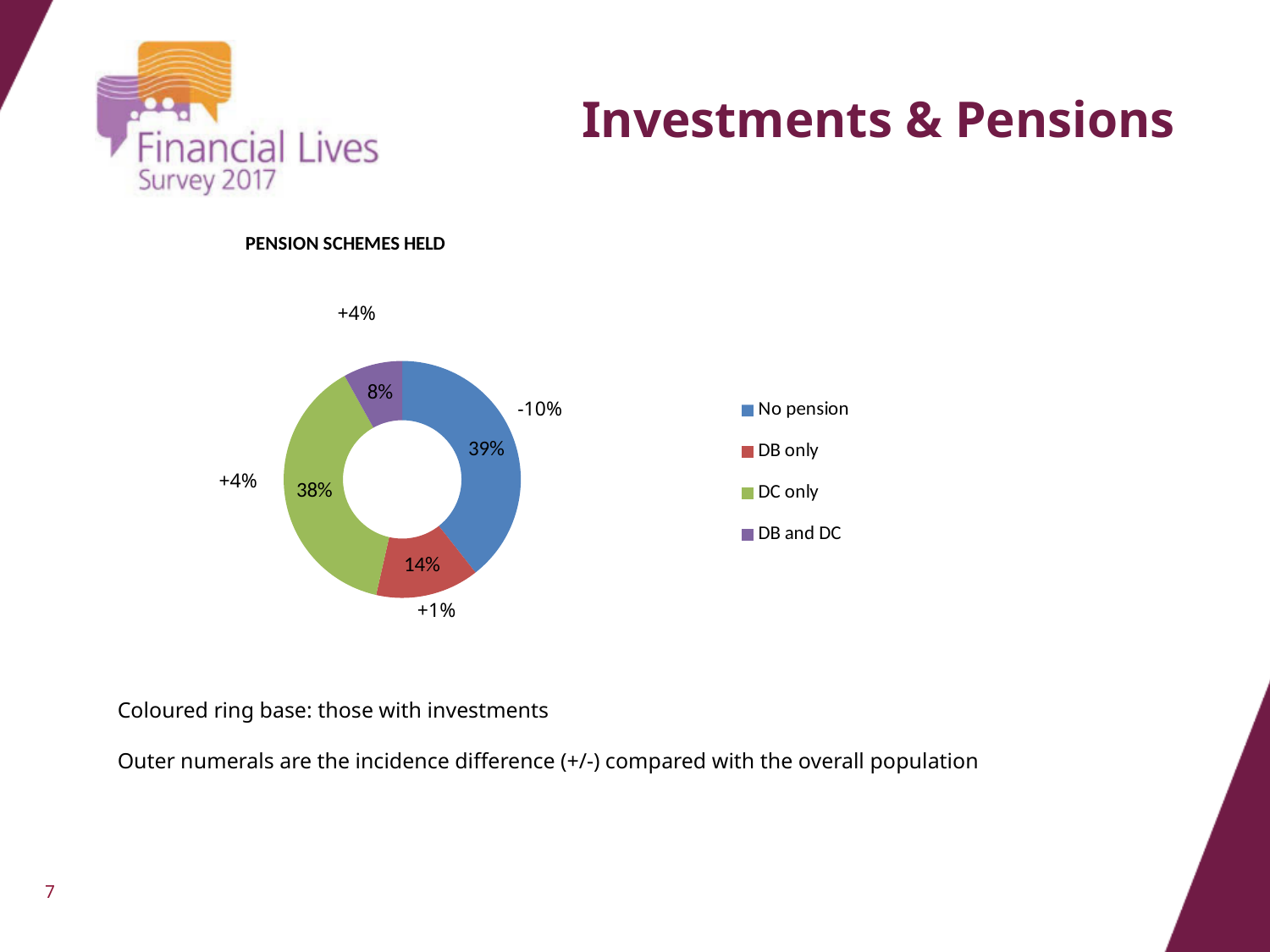
How many categories does the ring chart show? 4 Which category has the smallest share of the ring chart? DB and DC What kind of chart is shown on the slide? Doughnut chart Which is larger, the share for 'DB only' or the share for 'DB and DC'? DB only What share of the ring chart is 'DC only'? 38% What share of the ring chart is 'DB only'? 14% What is the incidence difference shown outside the ring for 'No pension'? -10% What is the difference in percentage points between the 'No pension' and 'DB only' shares? 25 What is the title of the chart? PENSION SCHEMES HELD What is the incidence difference shown outside the ring for 'DB only'? +1% What share of the ring chart is 'No pension'? 39% What share of the ring chart is 'DB and DC'? 8%